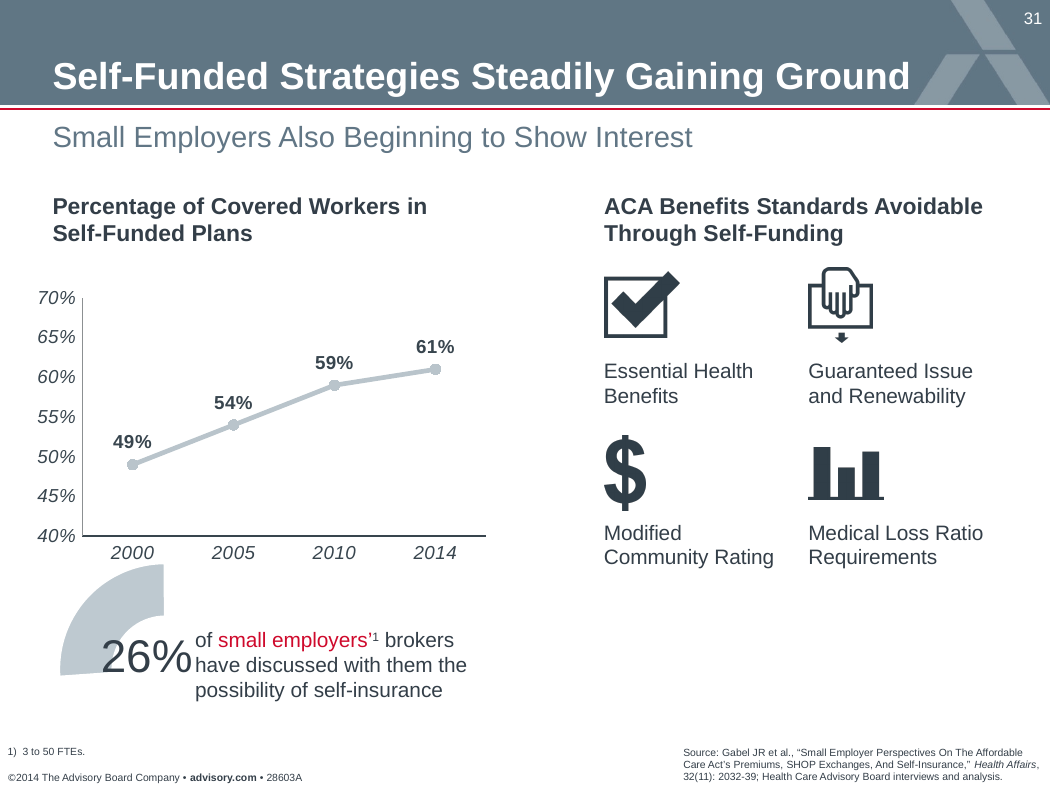
Which year has the highest percentage of covered workers in self-funded plans? 2014 Which year has the lowest percentage of covered workers in self-funded plans? 2000 Which is larger, the value for 2005 or the value for 2010? 2010 How many data points are plotted in the Percentage of Covered Workers in Self-Funded Plans chart? 4 What is the value shown for 2010 in the Percentage of Covered Workers in Self-Funded Plans chart? 59% Is the value for 2005 greater or less than 55%? less What percentage of covered workers were in self-funded plans in 2014? 61% Does the percentage of covered workers in self-funded plans rise or fall from 2000 to 2014? Rise What type of chart is used to show the percentage of covered workers in self-funded plans? Line chart By how many percentage points did the share of covered workers in self-funded plans increase from 2000 to 2014? 12 percentage points What is the difference between the 2005 and 2010 values in the chart? 5 percentage points What percentage of covered workers were in self-funded plans in 2000? 49%